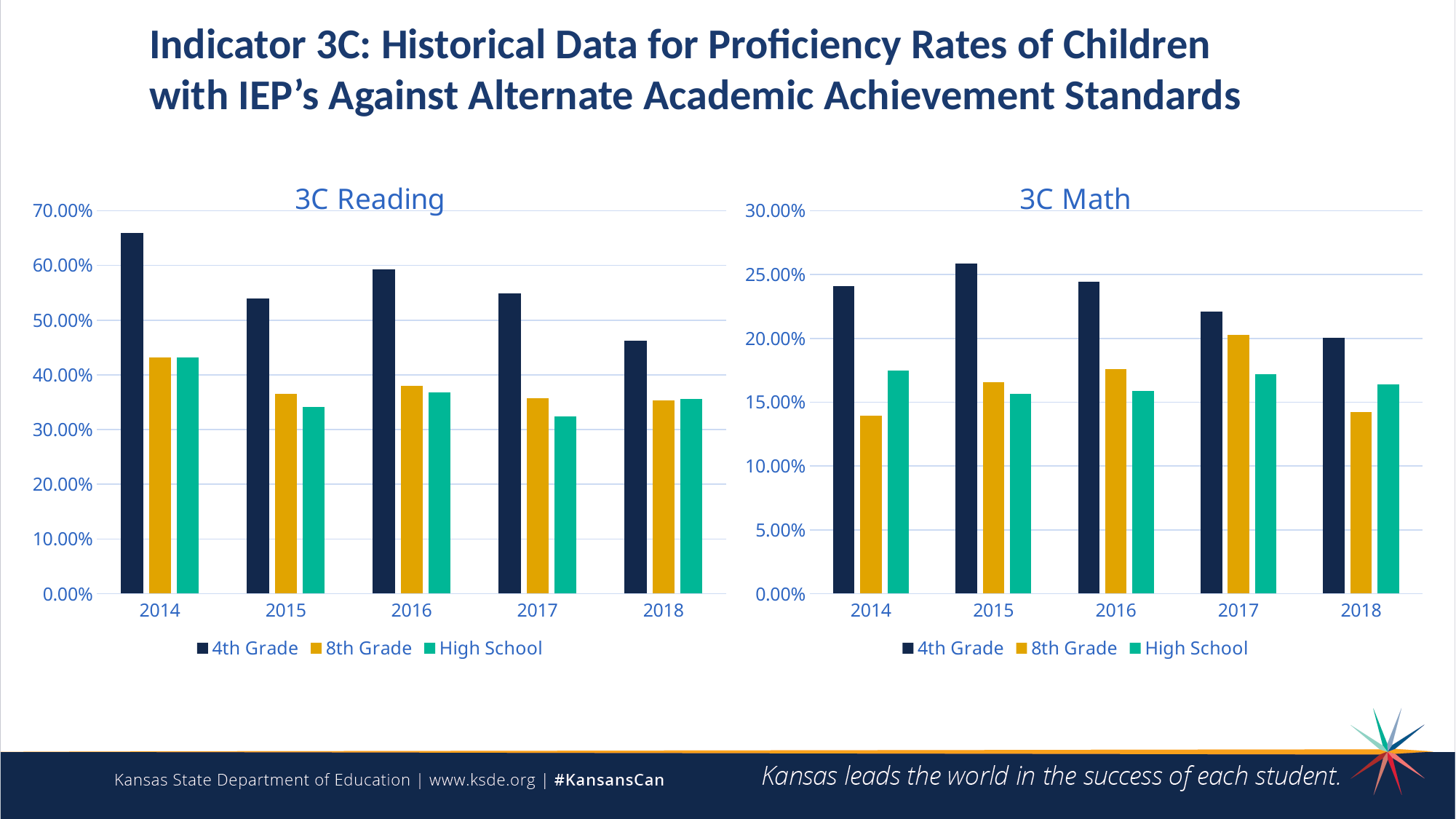
In the 3C Math chart, is the 8th Grade value for 2014 greater or less than 15.00%? less In the 3C Math chart, does the 4th Grade value rise or fall from 2015 to 2018? fall In the 3C Reading chart, is the 8th Grade value for 2015 greater or less than 40.00%? less In the 3C Math chart, which year has the highest 8th Grade value? 2017 In the 3C Math chart, which year has the highest 4th Grade value? 2015 In the 3C Math chart, for 2014, which is larger: 8th Grade or High School? High School How many series does the legend of the 3C Math chart list? 3 What kind of chart is the 3C Reading chart? Bar chart In the 3C Reading chart, which year has the lowest 4th Grade value? 2018 In the 3C Reading chart, which year has the highest 4th Grade value? 2014 How many years are shown on the x axis of the 3C Reading chart? 5 In the 3C Reading chart, is the 4th Grade value for 2014 greater or less than 60.00%? greater